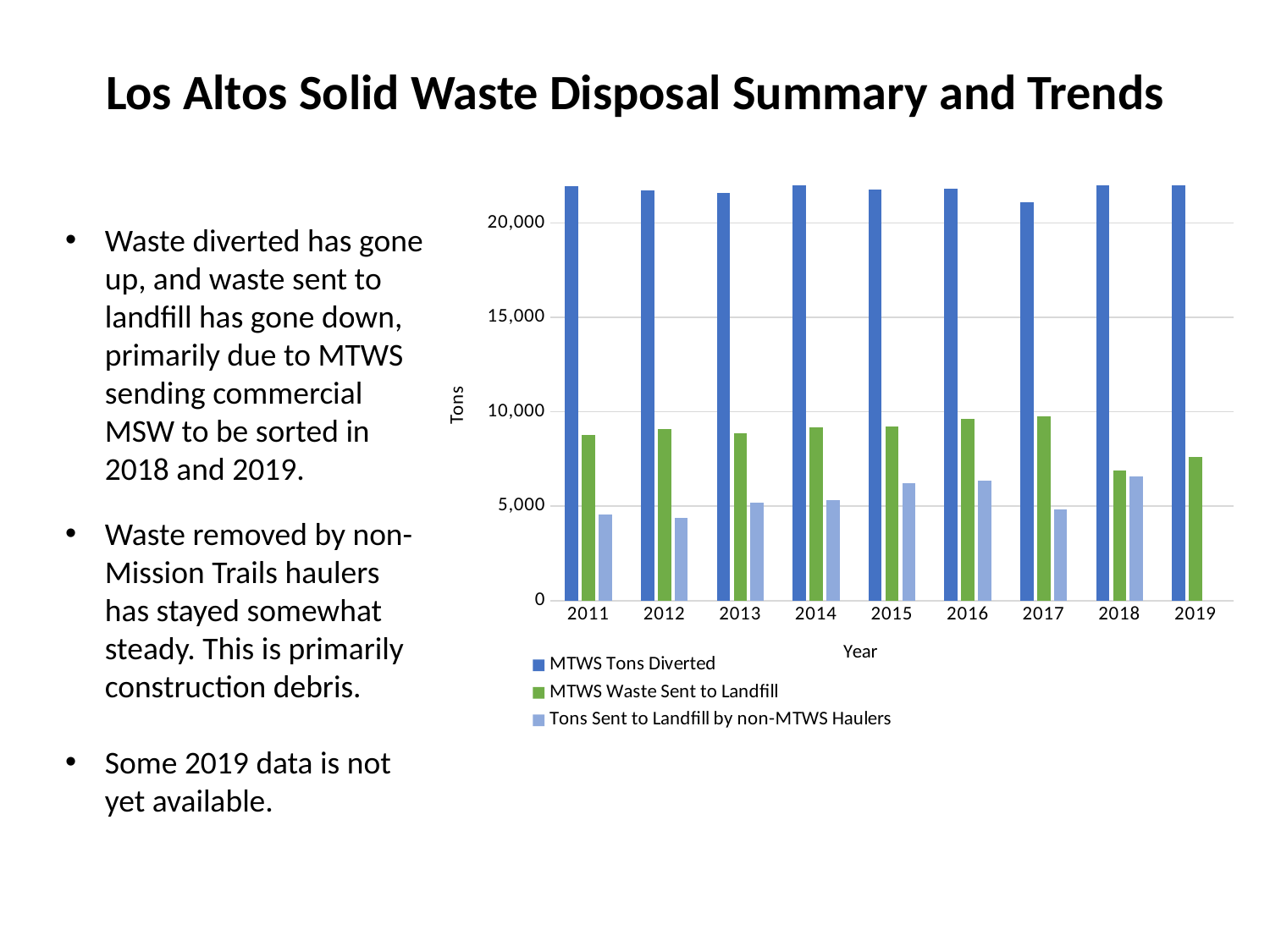
What kind of chart is shown on the slide? bar chart How many series does the chart legend list? 3 Is the value for MTWS Tons Diverted in 2011 greater or less than 20,000? greater In which year is MTWS Tons Diverted lowest? 2017 How many years are shown on the x axis of the chart? 9 What is the label on the vertical axis of the chart? Tons In 2011, which is larger: MTWS Waste Sent to Landfill or Tons Sent to Landfill by non-MTWS Haulers? MTWS Waste Sent to Landfill Is the value for Tons Sent to Landfill by non-MTWS Haulers in 2012 greater or less than 5,000? less In which year is MTWS Waste Sent to Landfill lowest? 2018 Is the value for MTWS Waste Sent to Landfill in 2018 greater or less than 10,000? less Does MTWS Waste Sent to Landfill rise or fall from 2017 to 2018? fall